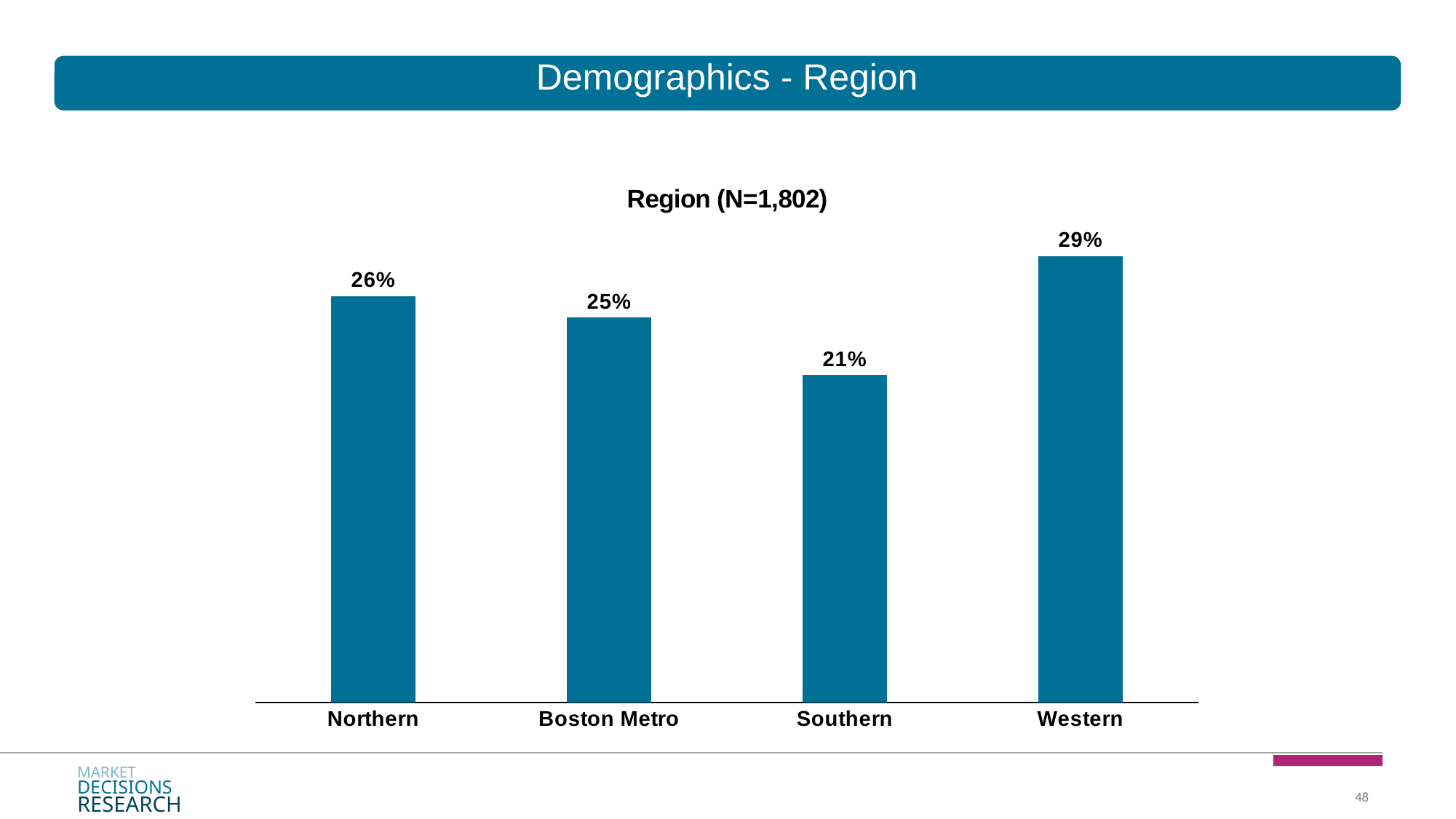
What is the value for Southern? 21% What is the value for Northern? 26% What kind of chart is shown on the slide? Bar chart Which region has the highest value? Western What is the value for Western? 29% Which region has the lowest value? Southern What is the difference between the values for Northern and Boston Metro? 1% How many regions are shown in the chart? 4 What is the title of the chart? Region (N=1,802) Which is larger, the value for Western or the value for Northern? Western What is the difference between the values for Western and Southern? 8% What is the value for Boston Metro? 25%